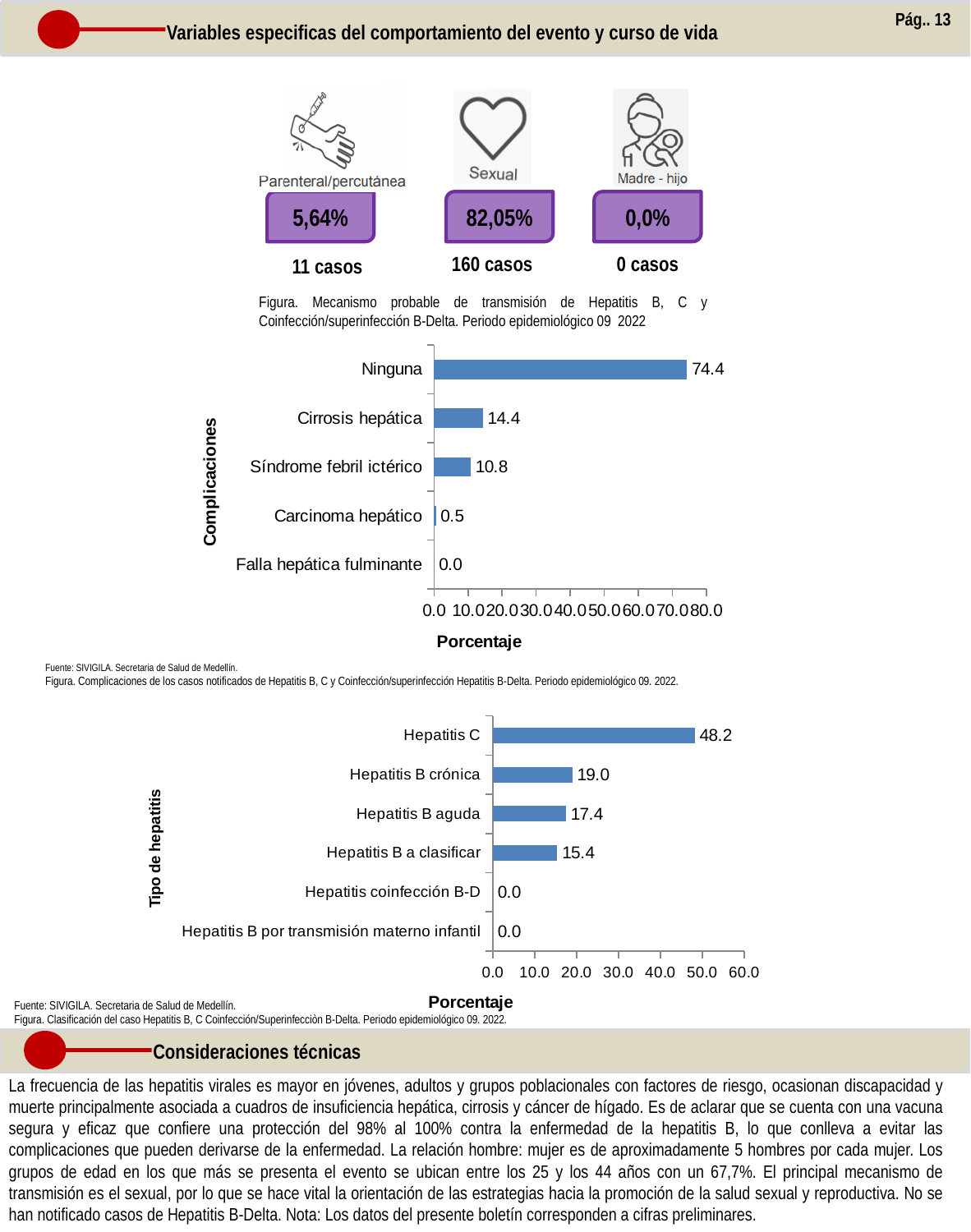
In the lower chart (Tipo de hepatitis), which is larger: Hepatitis B crónica or Hepatitis B aguda? Hepatitis B crónica In the upper chart (Complicaciones), what is the difference between Ninguna and Síndrome febril ictérico? 63.6 In the upper chart (Complicaciones), what is the value for Cirrosis hepática? 14.4 In the lower chart (Tipo de hepatitis), what is the value for Hepatitis C? 48.2 In the upper chart (Complicaciones), which complication has the highest percentage? Ninguna In the upper chart (Complicaciones), what kind of chart is it? Bar chart In the upper chart (Complicaciones), what is the value for Carcinoma hepático? 0.5 In the lower chart (Tipo de hepatitis), how many categories are shown on the y axis? 6 In the upper chart (Complicaciones), how many categories are shown on the y axis? 5 In the lower chart (Tipo de hepatitis), what is the value for Hepatitis coinfección B-D? 0.0 In the lower chart (Tipo de hepatitis), what is the difference between Hepatitis C and Hepatitis B a clasificar? 32.8 In the lower chart (Tipo de hepatitis), what is the label of the x axis? Porcentaje